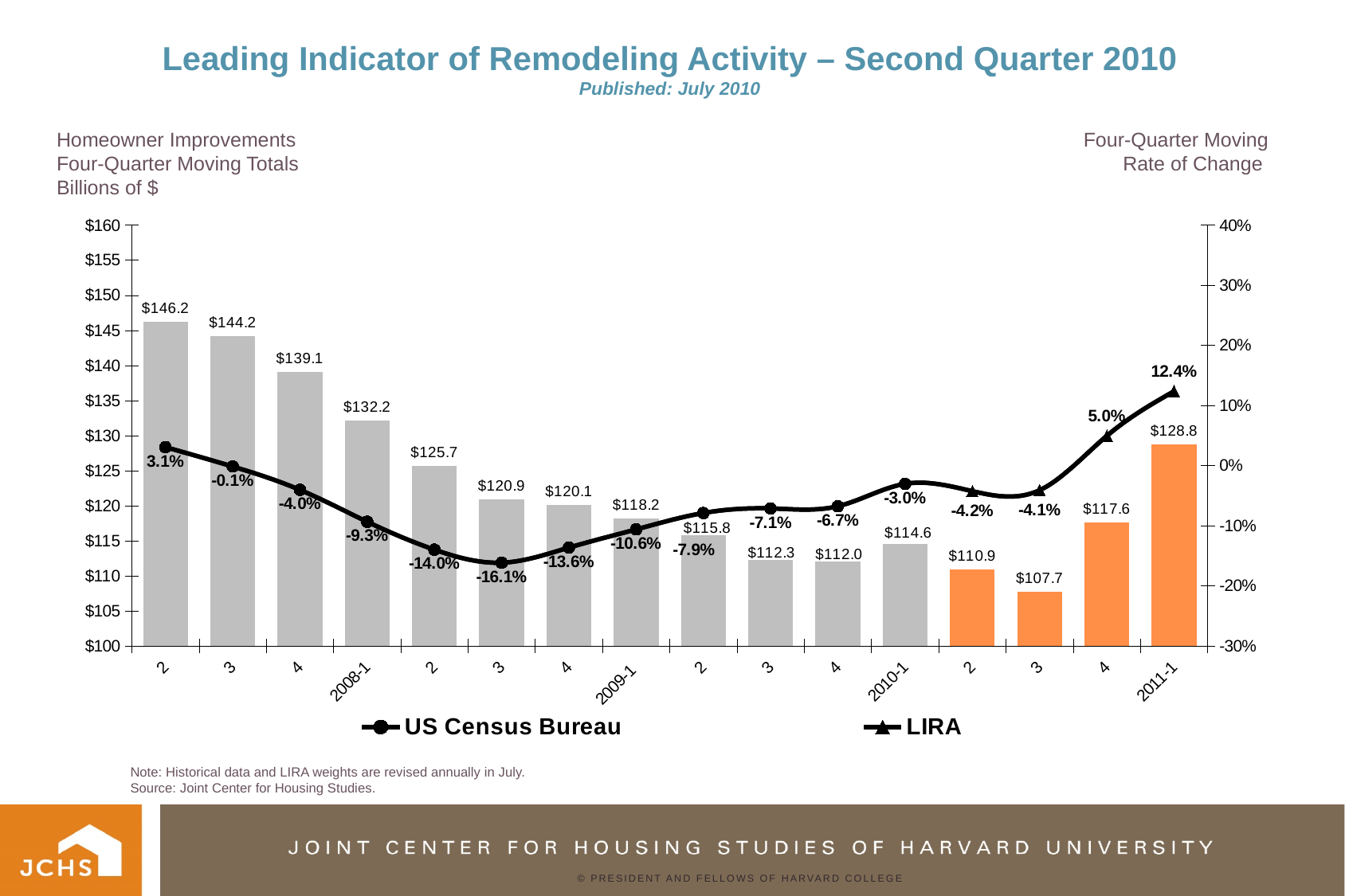
What is the LIRA four-quarter moving rate of change for the fourth quarter of 2010? 5.0% Which has the larger four-quarter moving total, 2009-1 or 2010-1? 2009-1 What is the difference between the four-quarter moving totals for 2009-1 and 2010-1? $3.6 What is the highest four-quarter moving rate of change shown on the line? 12.4% What is the four-quarter moving total for 2008-1? $132.2 What is the lowest four-quarter moving rate of change shown on the line? -16.1% How many bars are plotted on the chart? 16 Do the four-quarter moving totals rise or fall from the first bar through 2010-1? Fall What is the highest four-quarter moving total shown by the bars? $146.2 How many series does the legend list? 2 What kind of chart is this? Combined bar and line chart What is the four-quarter moving total projected for 2011-1? $128.8